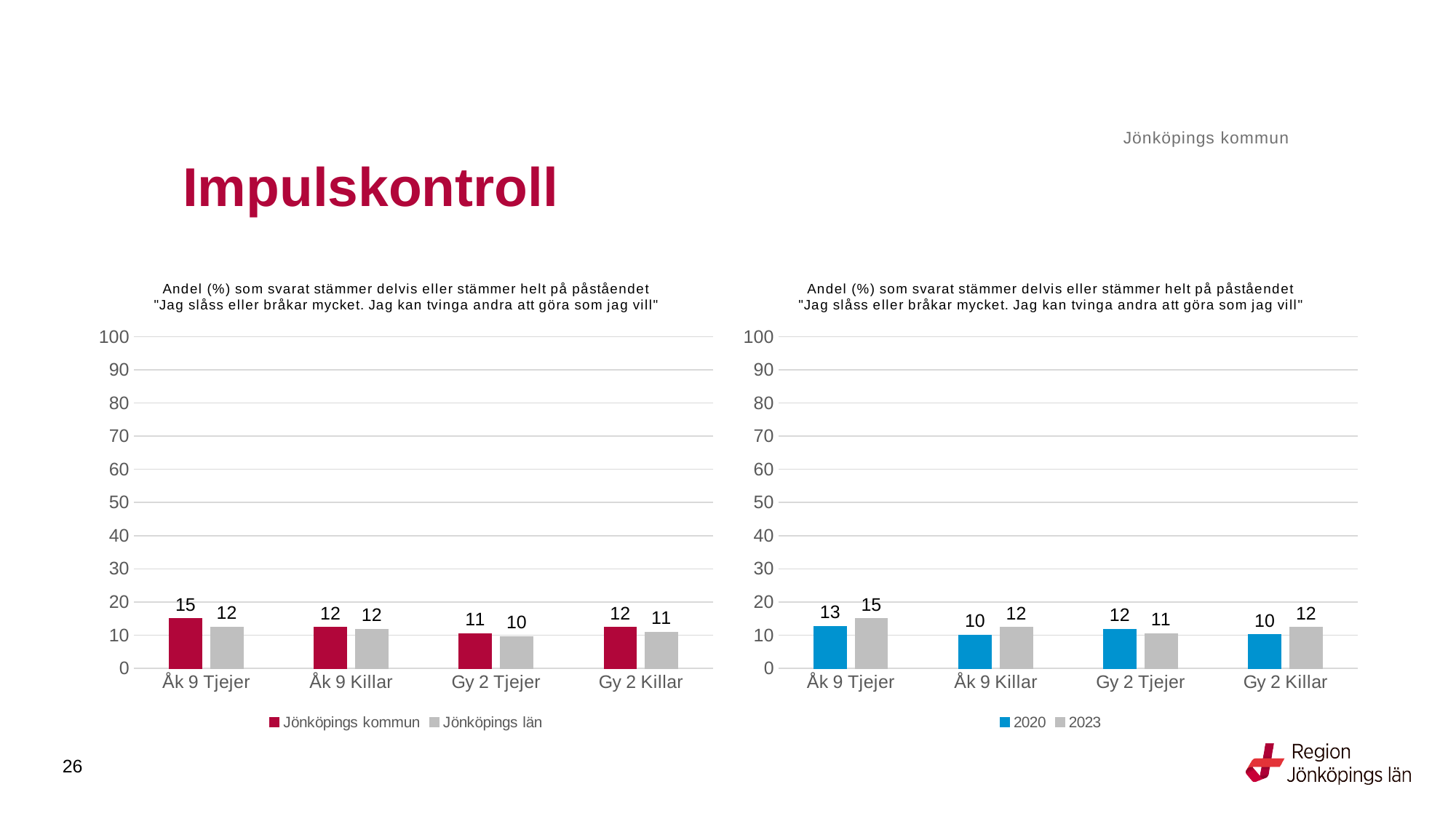
In the left chart, what is the value for Jönköpings kommun for Åk 9 Tjejer? 15 How many series does the legend of the left chart list? 2 In the left chart, what is the difference between Jönköpings kommun and Jönköpings län for Åk 9 Tjejer? 3 In the right chart, which is larger for Gy 2 Tjejer, 2020 or 2023? 2020 In the right chart, what is the value for 2023 for Åk 9 Tjejer? 15 In the right chart, what is the difference between 2023 and 2020 for Åk 9 Killar? 2 What kind of chart is the right chart? Bar chart In the right chart, what is the value for 2020 for Gy 2 Killar? 10 In the left chart, what is the value for Jönköpings län for Gy 2 Tjejer? 10 In the left chart, which category has the lowest value for Jönköpings län? Gy 2 Tjejer How many categories are shown on the x axis of the right chart? 4 In the left chart, which category has the highest value for Jönköpings kommun? Åk 9 Tjejer